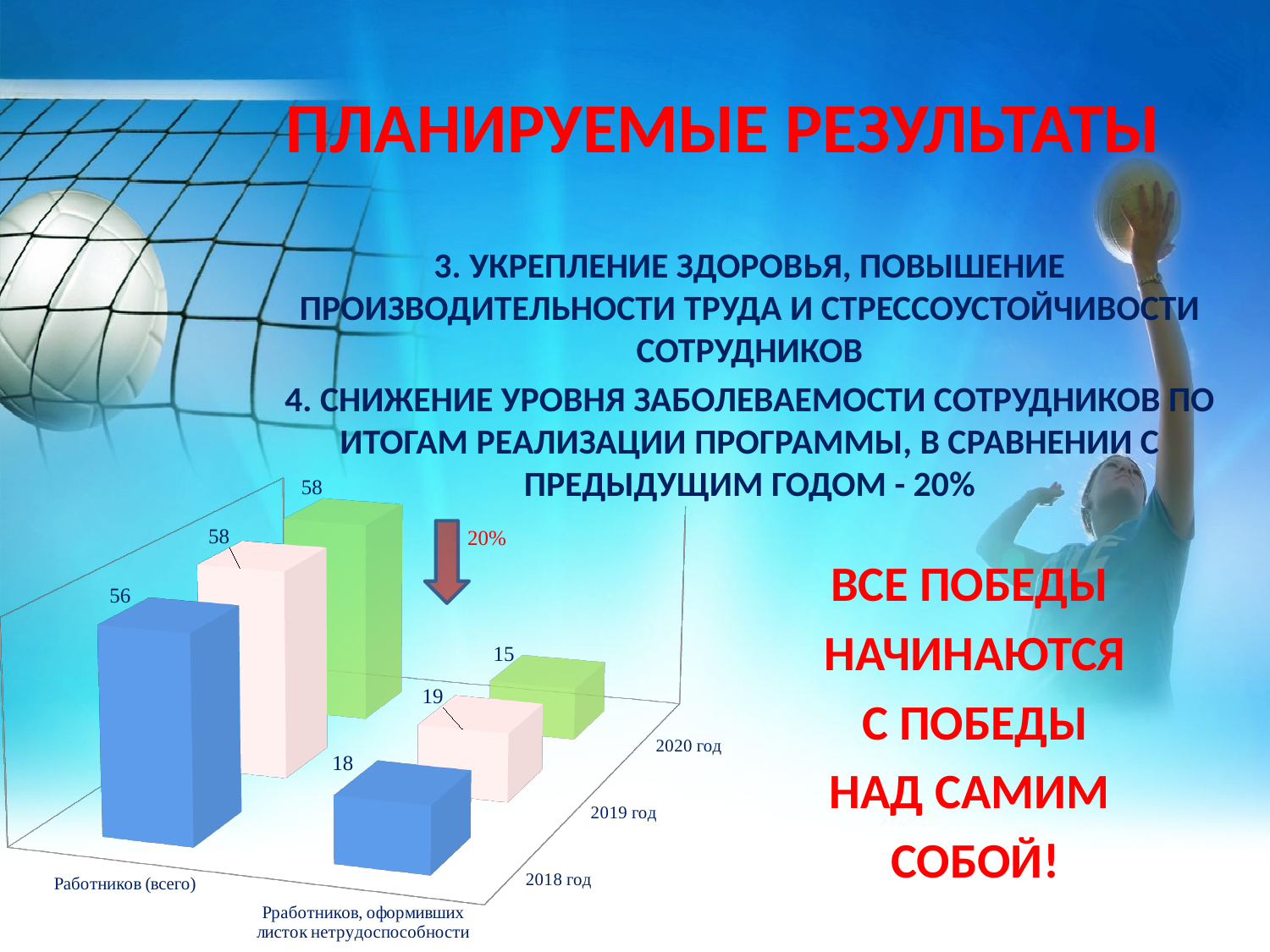
What kind of chart is shown on the slide? bar chart What is the value for Работников, оформивших листок нетрудоспособности in 2020 год? 15 What is the value for Работников, оформивших листок нетрудоспособности in 2019 год? 19 In which year is the value for Работников, оформивших листок нетрудоспособности the lowest? 2020 год What percentage is shown next to the downward arrow on the chart? 20% How many years are plotted in the chart? 3 What is the value for Работников (всего) in 2018 год? 56 Which is larger: the 2018 год value for Работников (всего) or the 2019 год value for Работников (всего)? 2019 год In which year is the value for Работников, оформивших листок нетрудоспособности the highest? 2019 год What is the difference between the 2019 год and 2020 год values for Работников, оформивших листок нетрудоспособности? 4 What is the value for Работников, оформивших листок нетрудоспособности in 2018 год? 18 What is the value for Работников (всего) in 2019 год? 58